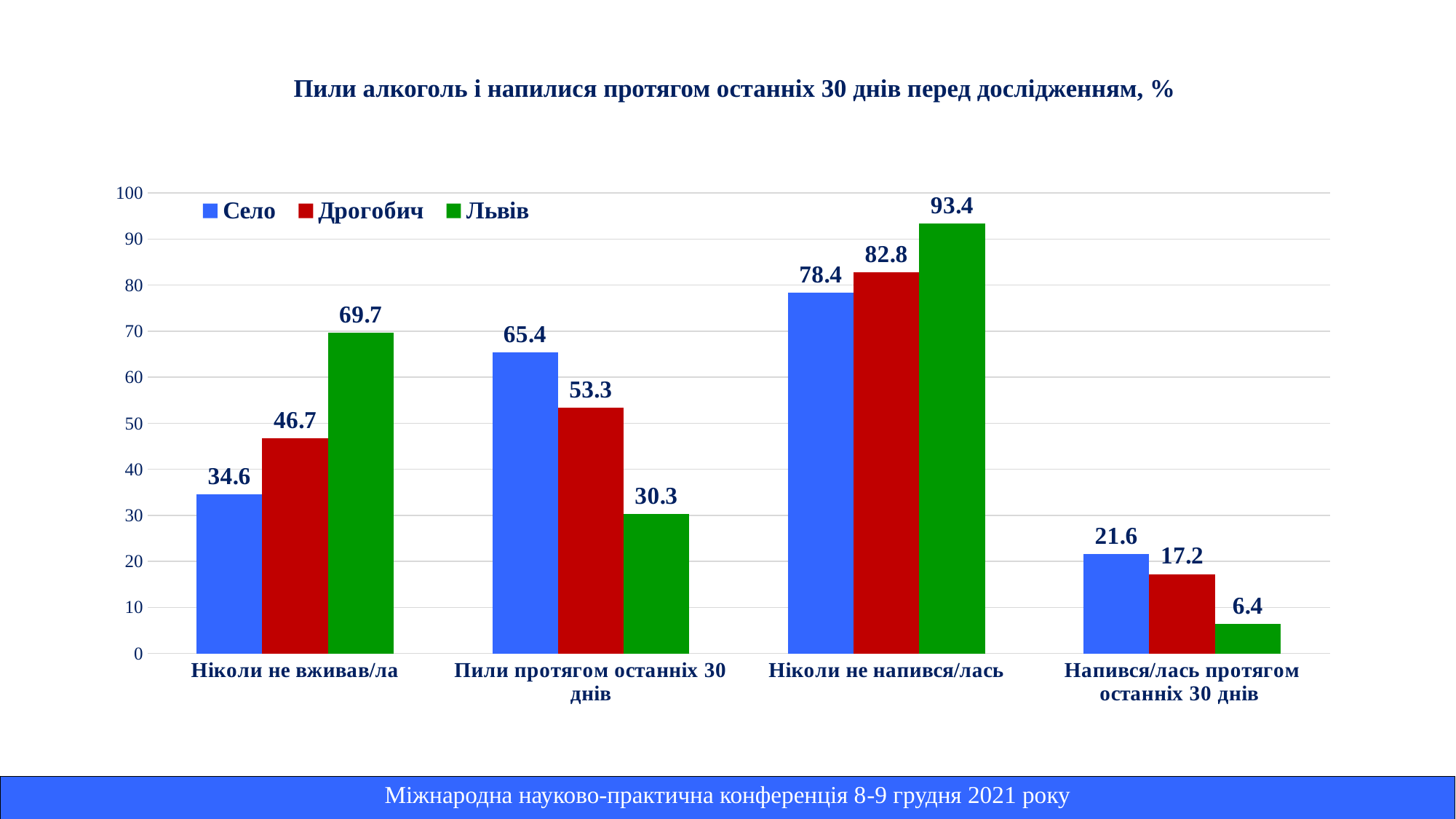
Is the value for Дрогобич in the category 'Ніколи не напився/лась' greater or less than 80? greater What is the difference between the Дрогобич and Село values in the category 'Ніколи не вживав/ла'? 12.1 What is the value for Дрогобич in the category 'Напився/лась протягом останніх 30 днів'? 17.2 Which series has the lowest value in the category 'Напився/лась протягом останніх 30 днів'? Львів How many categories are shown on the x axis? 4 Which series has the highest value in the category 'Ніколи не напився/лась'? Львів What kind of chart is shown on the slide? bar chart How many series does the legend list? 3 What colour represents the Дрогобич series in the chart? red Which is larger in the category 'Пили протягом останніх 30 днів': the value for Село or the value for Львів? Село What is the value for Село in the category 'Пили протягом останніх 30 днів'? 65.4 What is the value for Львів in the category 'Ніколи не вживав/ла'? 69.7